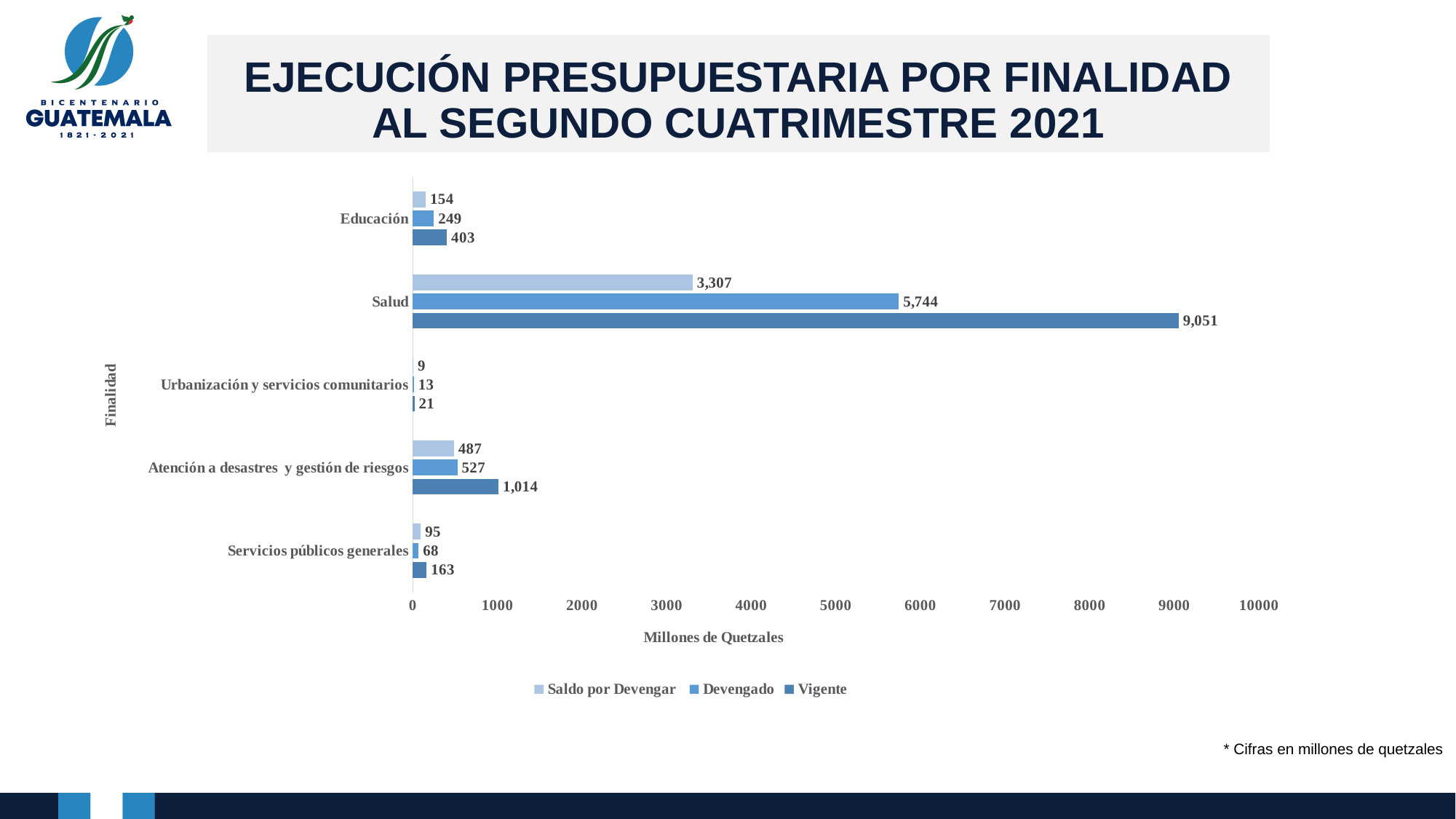
Is the Vigente value for Atención a desastres y gestión de riesgos greater or less than 1000? greater What is the Saldo por Devengar value for Educación? 154 What kind of chart is shown on the slide? Bar chart What is the Vigente value for Salud? 9,051 What is the Devengado value for Atención a desastres y gestión de riesgos? 527 What is the difference between the Vigente and Devengado values for Salud? 3,307 Which category has the lowest Devengado value? Urbanización y servicios comunitarios Which category has the highest Vigente value? Salud How many categories are shown on the y axis? 5 How many series does the legend list? 3 What is the label of the x axis? Millones de Quetzales Which is larger for Servicios públicos generales: Saldo por Devengar or Devengado? Saldo por Devengar